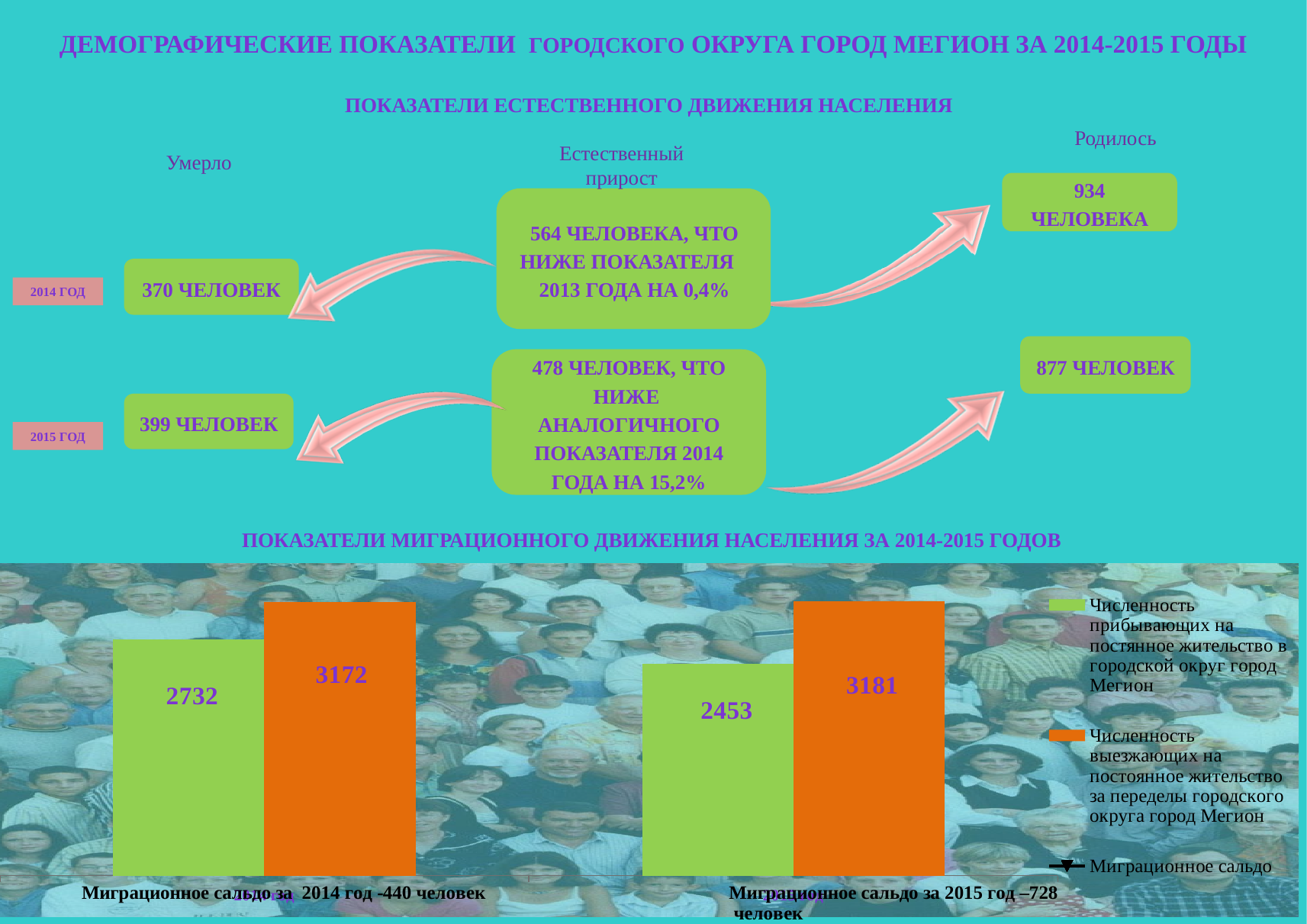
In the migration bar chart, what is the difference between departures and arrivals in 2015? 728 In the migration bar chart, which bar has the highest value? Departures in 2015 (3181) How many entries does the legend of the migration chart list? 3 In the migration bar chart, what is the difference between departures and arrivals in 2014? 440 In the migration bar chart, what is the number of people leaving for permanent residence in 2014? 3172 What type of chart is used to show the migration indicators? Bar chart In the migration bar chart, what is the number of people leaving for permanent residence in 2015? 3181 In the migration bar chart, what is the number of people arriving for permanent residence in 2014? 2732 In the migration bar chart, were arrivals higher in 2014 or in 2015? 2014 In the migration bar chart, which bar has the lowest value? Arrivals in 2015 (2453) In the migration bar chart, what is the number of people arriving for permanent residence in 2015? 2453 In the migration bar chart, do arrivals rise or fall from 2014 to 2015? Fall